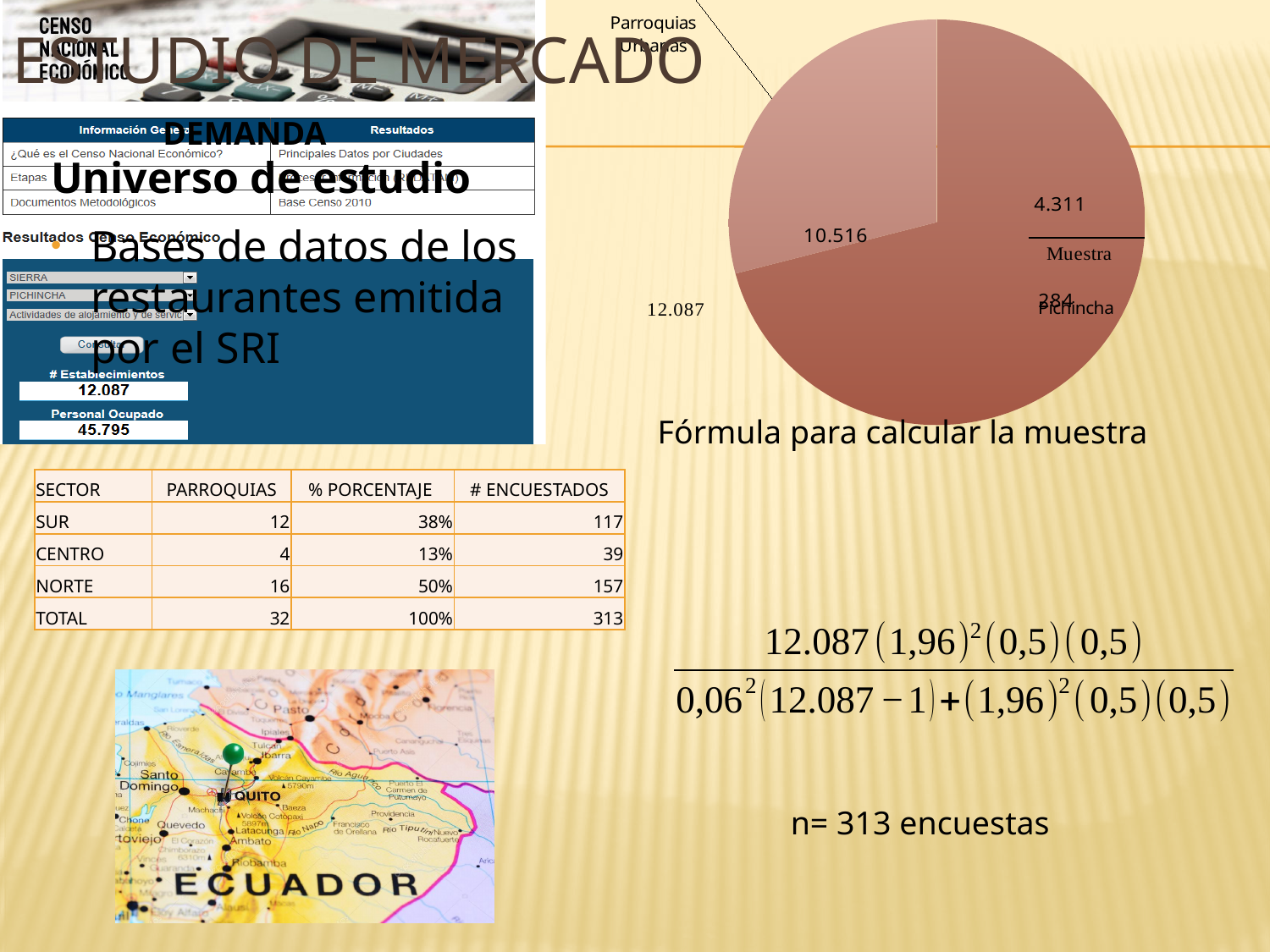
Does the pie chart show a legend? No What is the value of the largest slice in the pie chart? 10.516 How many slices does the pie chart have? 2 What label is attached to the pie chart by a leader line? Parroquias Urbanas What is the value of the smallest slice in the pie chart? 4.311 What kind of chart is shown on the right side of the slide? pie chart In the pie chart, which slice is larger: the one labelled 10.516 or the one labelled 4.311? 10.516 What is the difference between the two slice values in the pie chart, 10.516 and 4.311? 6.205